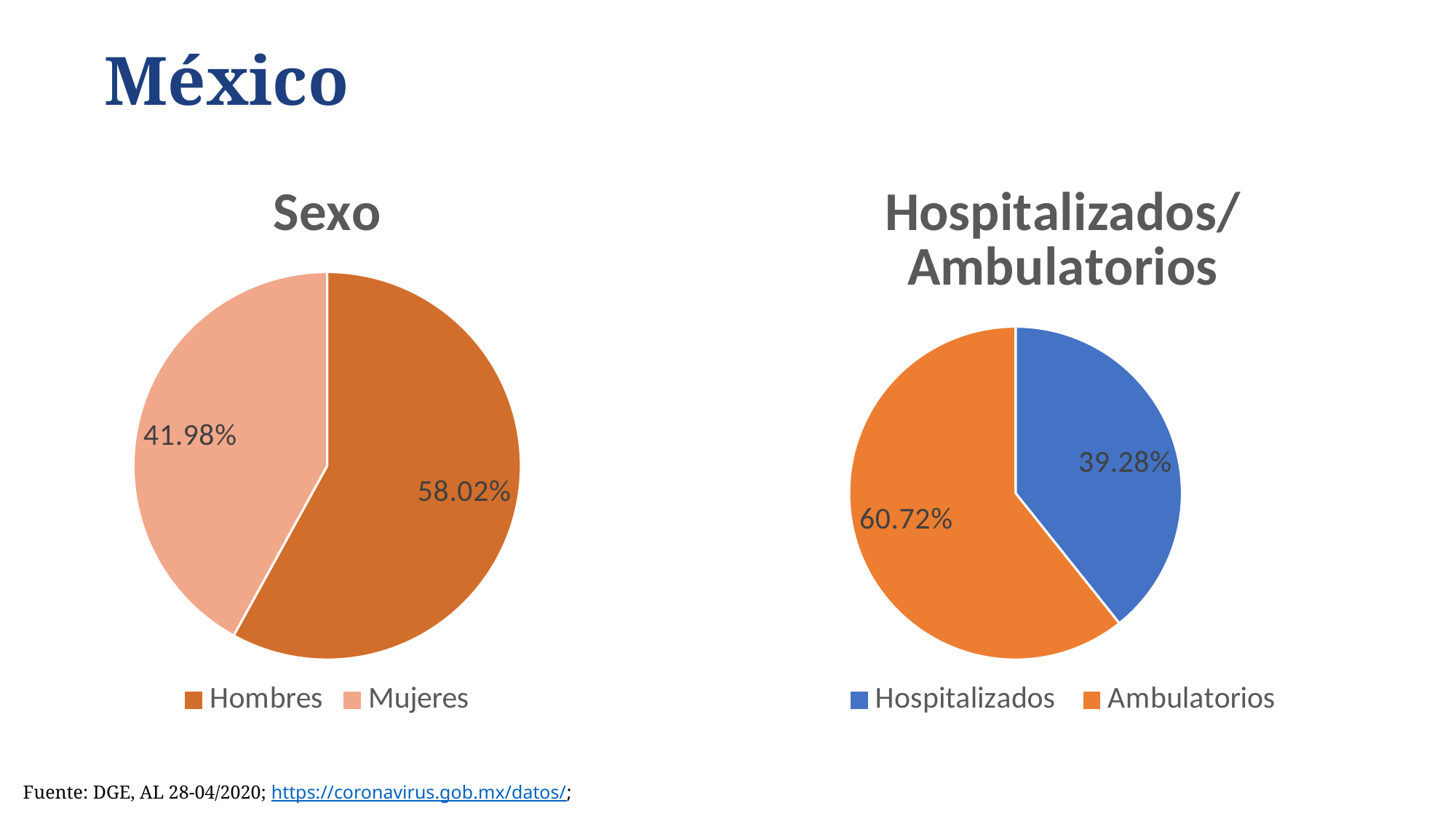
In the 'Hospitalizados/Ambulatorios' chart, what colour is the Hospitalizados slice? Blue In the 'Hospitalizados/Ambulatorios' chart, what percentage is shown for Hospitalizados? 39.28% In the 'Sexo' chart, which category has the largest share? Hombres In the 'Sexo' chart, what percentage is shown for Mujeres? 41.98% In the 'Hospitalizados/Ambulatorios' chart, which is larger, Hospitalizados or Ambulatorios? Ambulatorios In the 'Hospitalizados/Ambulatorios' chart, what is the difference in percentage points between Ambulatorios and Hospitalizados? 21.44 In the 'Hospitalizados/Ambulatorios' chart, which category has the smallest share? Hospitalizados In the 'Sexo' chart, what percentage is shown for Hombres? 58.02% In the 'Hospitalizados/Ambulatorios' chart, what percentage is shown for Ambulatorios? 60.72% What kind of chart is the 'Sexo' chart? Pie chart How many categories does the 'Hospitalizados/Ambulatorios' chart show? 2 In the 'Sexo' chart, what is the difference in percentage points between Hombres and Mujeres? 16.04